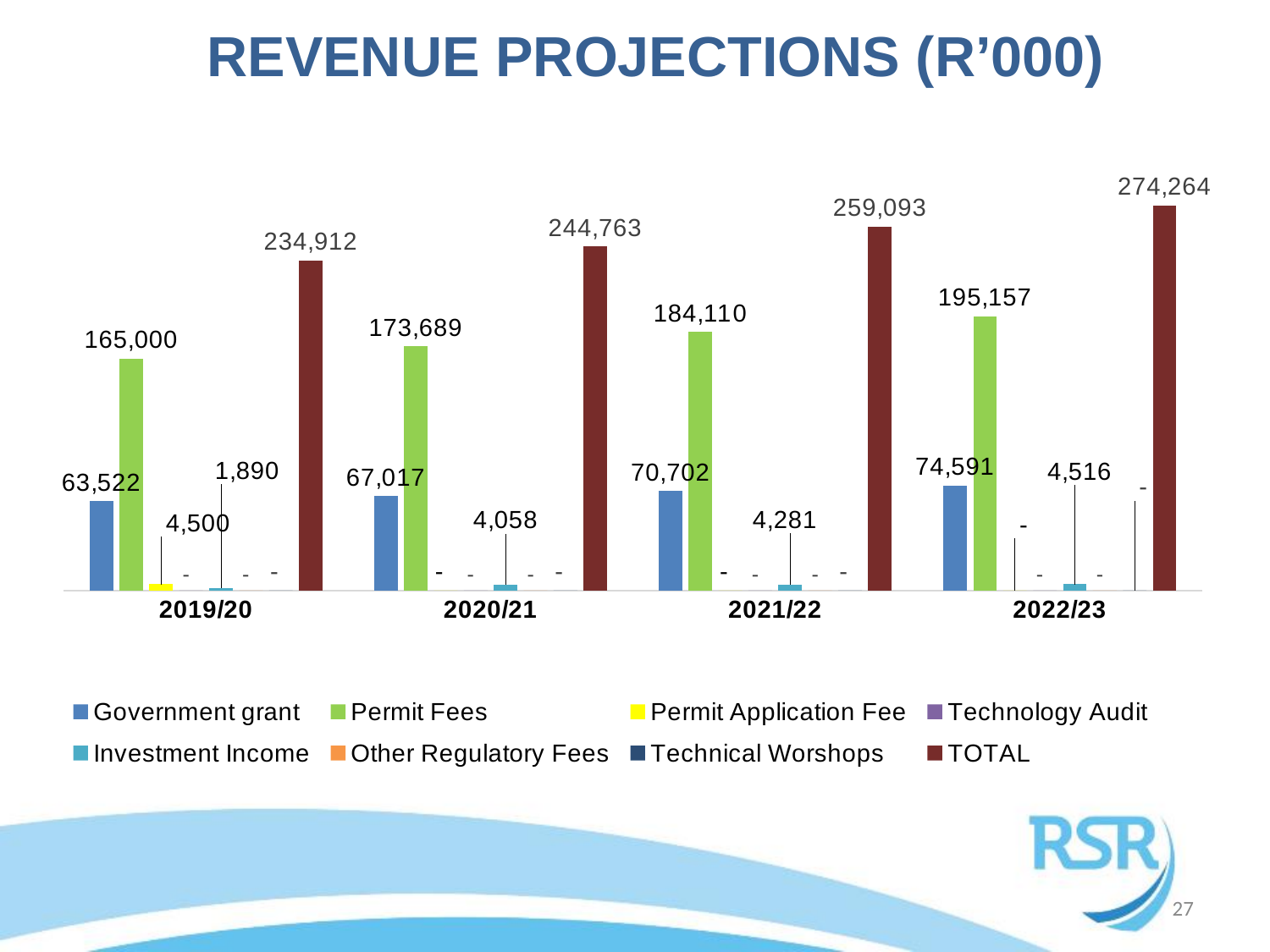
By how much does the TOTAL for 2022/23 exceed the TOTAL for 2019/20? 39,352 What type of chart is shown on the slide? Bar chart How many financial years are shown on the x axis? 4 In which year is the Government grant lowest? 2019/20 What is the Investment Income value for 2022/23? 4,516 Which is larger: the Government grant in 2022/23 or Permit Fees in 2019/20? Permit Fees in 2019/20 In which year is the TOTAL revenue projection highest? 2022/23 How many series does the legend list? 8 What is the Permit Fees value for 2020/21? 173,689 What is the difference between Permit Fees in 2021/22 and 2020/21? 10,421 What is the Government grant value for 2021/22? 70,702 What is the TOTAL revenue projection for 2022/23? 274,264